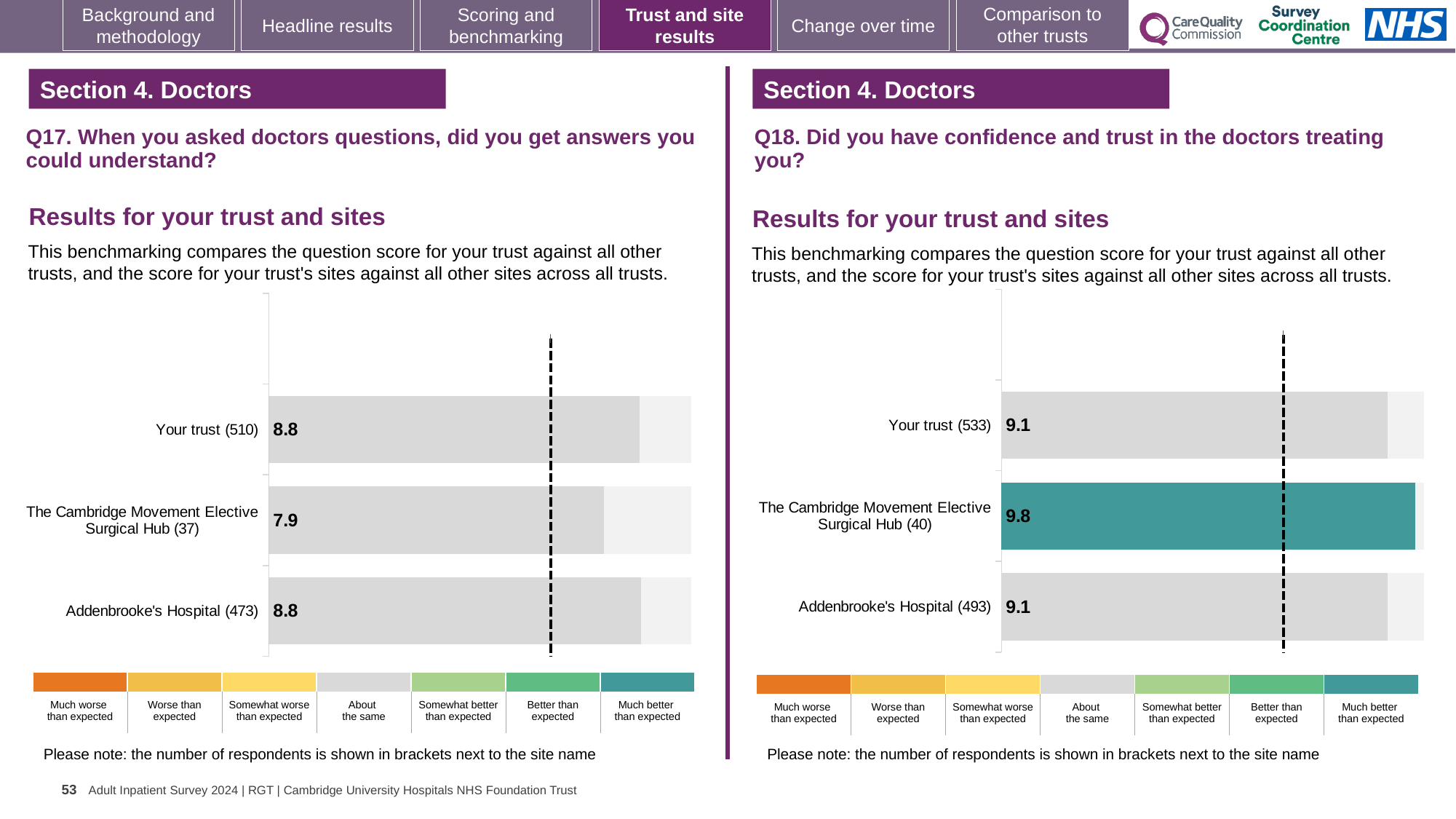
On the Q18 chart (right), what is the difference between the score for The Cambridge Movement Elective Surgical Hub (40) and Addenbrooke's Hospital (493)? 0.7 On the Q17 chart (left), what is the score for Your trust (510)? 8.8 On the Q18 chart (right), which has the larger score: Your trust (533) or The Cambridge Movement Elective Surgical Hub (40)? The Cambridge Movement Elective Surgical Hub (40) On the Q18 chart (right), which benchmarking category does the colour of The Cambridge Movement Elective Surgical Hub (40) bar correspond to in the legend? Much better than expected On the Q18 chart (right), what is the score for Addenbrooke's Hospital (493)? 9.1 On the Q17 chart (left), which site or trust has the lowest score? The Cambridge Movement Elective Surgical Hub (37) How many bars are shown on the Q17 chart (left)? 3 On the Q18 chart (right), what is the score for The Cambridge Movement Elective Surgical Hub (40)? 9.8 What type of chart is used on the Q18 chart (right)? Bar chart On the Q17 chart (left), what is the score for The Cambridge Movement Elective Surgical Hub (37)? 7.9 On the Q17 chart (left), what is the difference between the score for Your trust (510) and The Cambridge Movement Elective Surgical Hub (37)? 0.9 On the Q18 chart (right), which site or trust has the highest score? The Cambridge Movement Elective Surgical Hub (40)